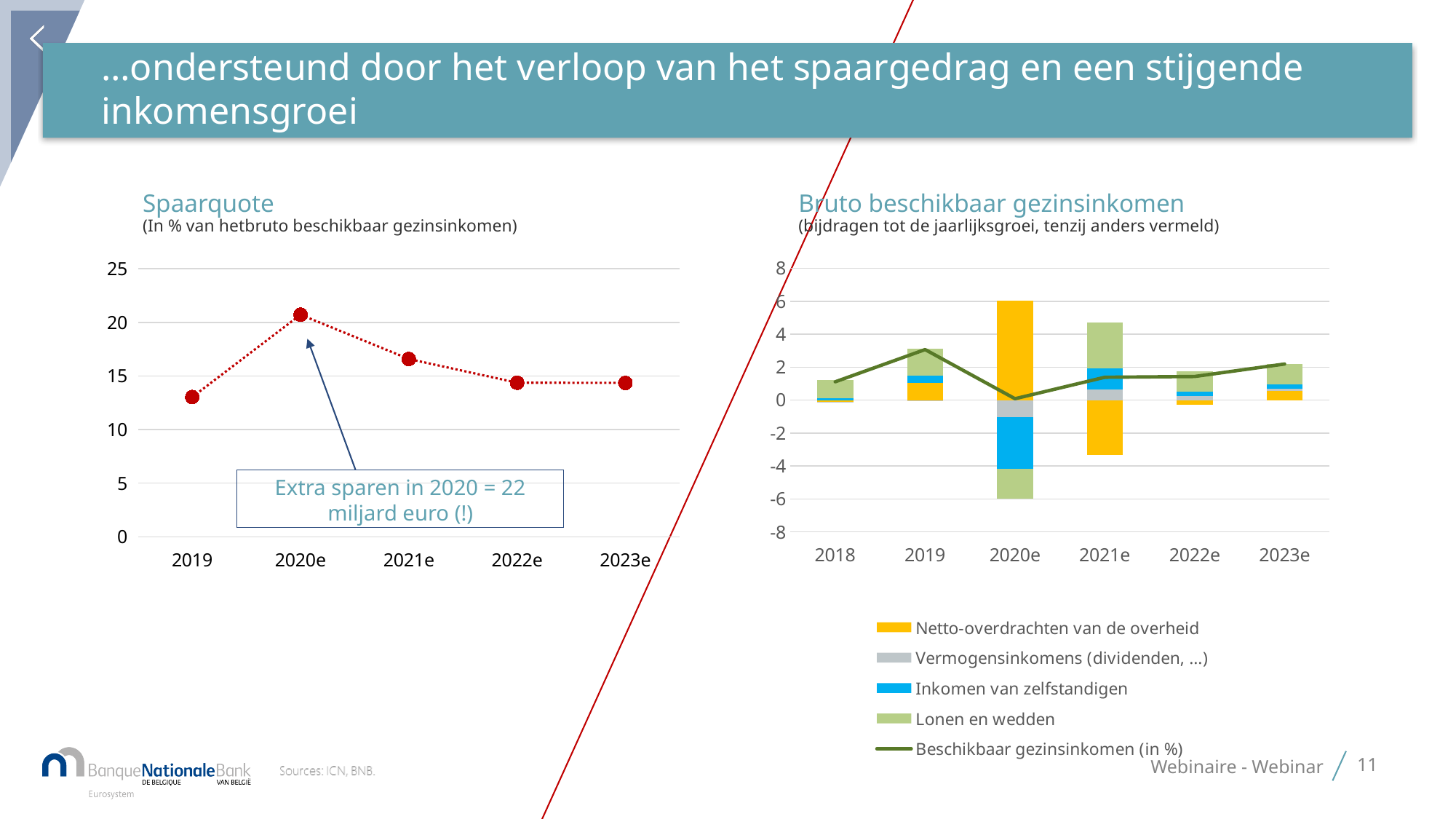
In the Spaarquote chart, is the value for 2019 greater or less than 15? less In the Spaarquote chart, is the value for 2021e greater or less than 15? greater In the Bruto beschikbaar gezinsinkomen chart, is the Netto-overdrachten van de overheid contribution for 2020e greater or less than 4? greater In the Spaarquote chart, do the values rise or fall from 2020e to 2022e? fall How many years are plotted on the Spaarquote chart? 5 According to the annotation on the Spaarquote chart, how much extra saving was there in 2020? 22 miljard euro In the Spaarquote chart, which year has the highest savings rate? 2020e How many series does the legend of the Bruto beschikbaar gezinsinkomen chart list? 5 What kind of chart is the Spaarquote chart on the left? line chart What kind of chart is the Bruto beschikbaar gezinsinkomen chart on the right? stacked bar chart with a line How many years are shown on the x axis of the Bruto beschikbaar gezinsinkomen chart? 6 In the Spaarquote chart, which is larger, the value for 2020e or the value for 2021e? 2020e